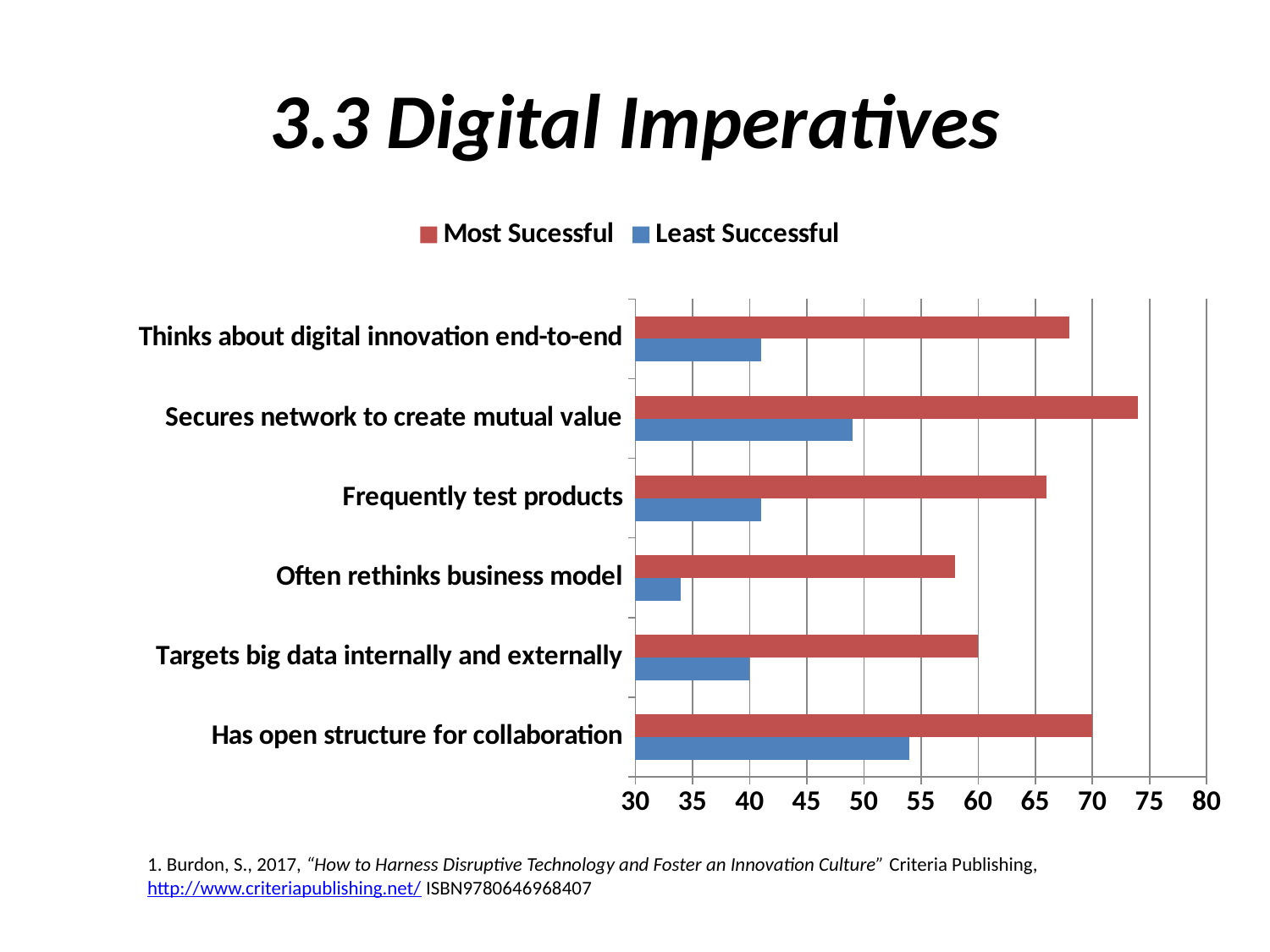
Which category has the highest Most Successful value? Secures network to create mutual value Which category has the highest Least Successful value? Has open structure for collaboration How many series does the chart legend list? 2 Is the Most Successful value for Thinks about digital innovation end-to-end greater or less than 65? greater How many categories are plotted on the chart? 6 What kind of chart is shown on the slide? bar chart Is the Most Successful value for Secures network to create mutual value greater or less than 70? greater Which category has the lowest Least Successful value? Often rethinks business model Is the Least Successful value for Often rethinks business model greater or less than 35? less For Frequently test products, which series has the larger value, Most Successful or Least Successful? Most Successful Which series is shown in red on the chart? Most Sucessful